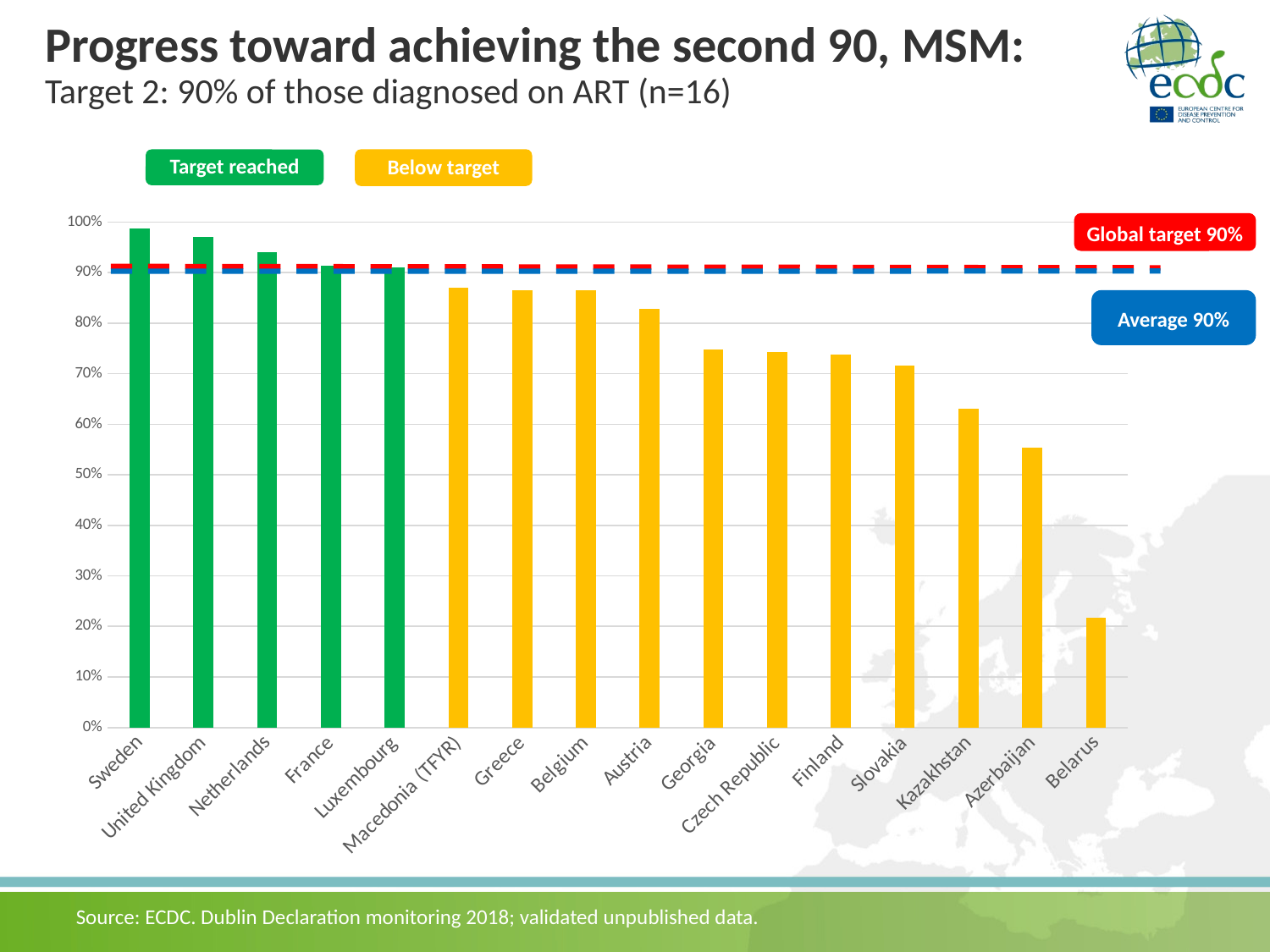
Is the value for Austria greater or less than 90%? less Which has a larger value, Netherlands or Greece? Netherlands Is the value for Azerbaijan greater or less than 50%? greater Which country has the lowest value in the chart? Belarus Which country has the highest value in the chart? Sweden Is the value for Sweden greater or less than 90%? greater How many countries are shown on the x axis of the chart? 16 Do the bar values rise or fall moving from left to right along the x axis? Fall What kind of chart is shown on the slide? Bar chart How many countries are shown with green bars (target reached)? 5 What global target value is marked by the dashed line on the chart? 90%